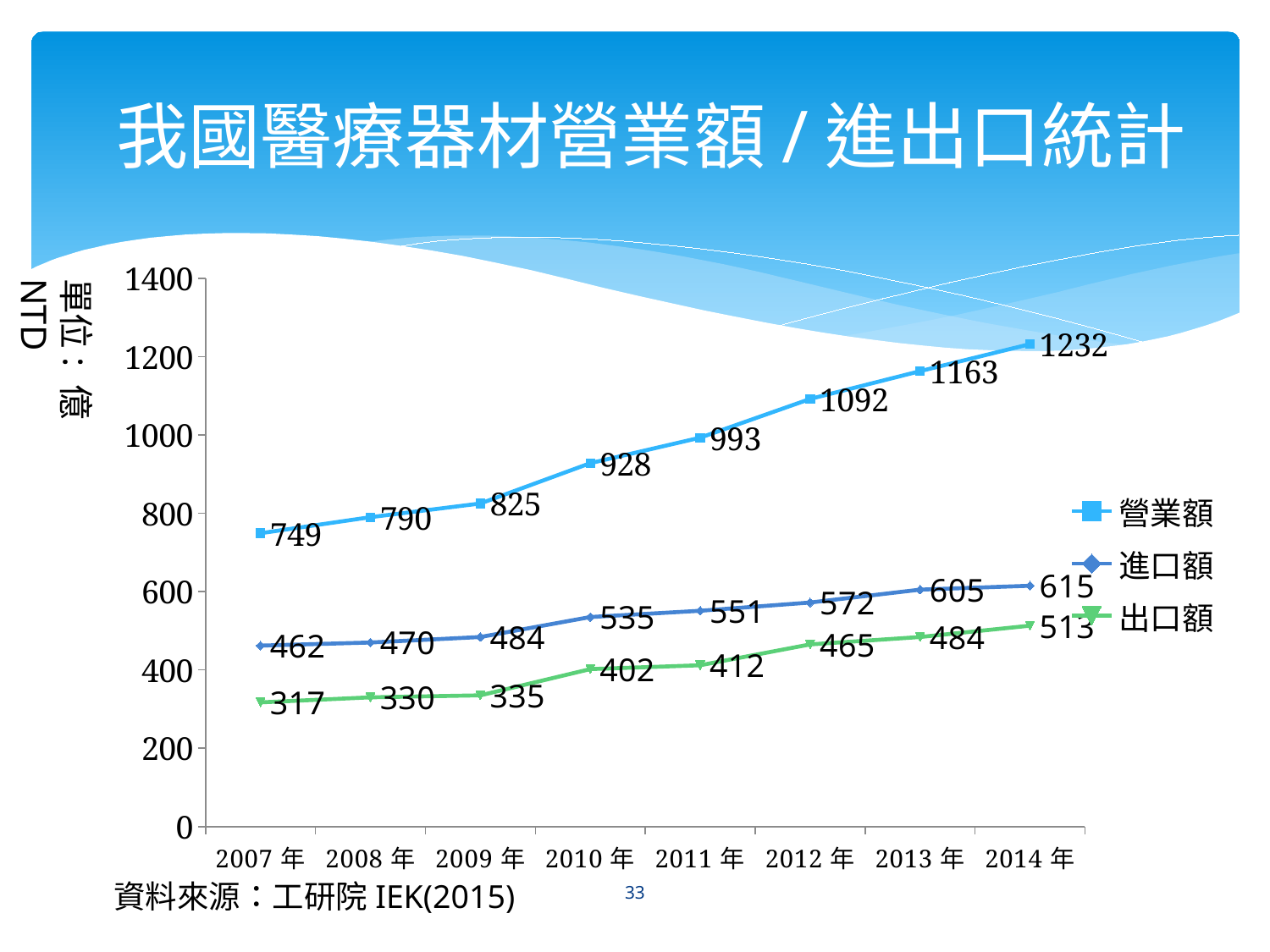
What is the 進口額 value for 2010 年? 535 What is the difference between 進口額 and 出口額 in 2014 年? 102 In which year is 營業額 lowest? 2007 年 What kind of chart is shown on the slide? line chart In which year is 出口額 highest? 2014 年 What is the 出口額 value for 2007 年? 317 How many years are shown on the x axis? 8 Is the 營業額 value for 2011 年 greater or less than 1000? less By how much did 營業額 increase from 2007 年 to 2014 年? 483 How many series does the legend list? 3 Which is larger in 2012 年, 進口額 or 出口額? 進口額 What is the 營業額 value for 2014 年? 1232